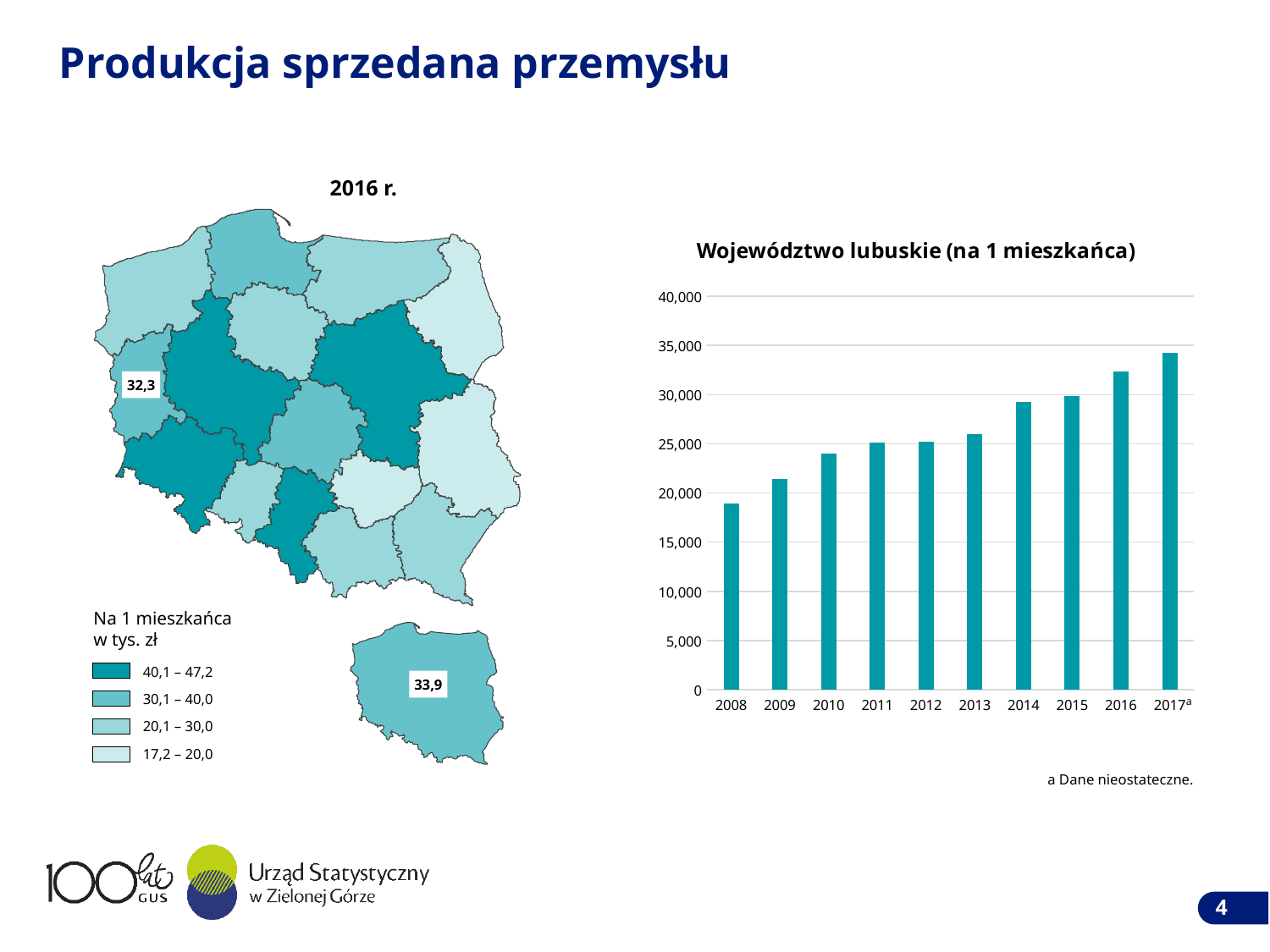
In the 'Województwo lubuskie (na 1 mieszkańca)' chart, is the value for 2017 greater or less than 35,000? less What is the title of the bar chart on the right of the slide? Województwo lubuskie (na 1 mieszkańca) In the 'Województwo lubuskie (na 1 mieszkańca)' chart, do the values generally rise or fall from 2008 to 2017? rise What is the highest value shown on the y axis of the 'Województwo lubuskie (na 1 mieszkańca)' chart? 40,000 In the 'Województwo lubuskie (na 1 mieszkańca)' chart, is the value for 2008 greater or less than 20,000? less What kind of chart is 'Województwo lubuskie (na 1 mieszkańca)'? bar chart In the 'Województwo lubuskie (na 1 mieszkańca)' chart, is the value for 2016 greater or less than 30,000? greater In the 'Województwo lubuskie (na 1 mieszkańca)' chart, which year has the highest bar? 2017 In the 'Województwo lubuskie (na 1 mieszkańca)' chart, which is larger, the value for 2014 or the value for 2010? 2014 In the 'Województwo lubuskie (na 1 mieszkańca)' chart, which year has the lowest bar? 2008 How many years are shown on the x axis of the 'Województwo lubuskie (na 1 mieszkańca)' chart? 10